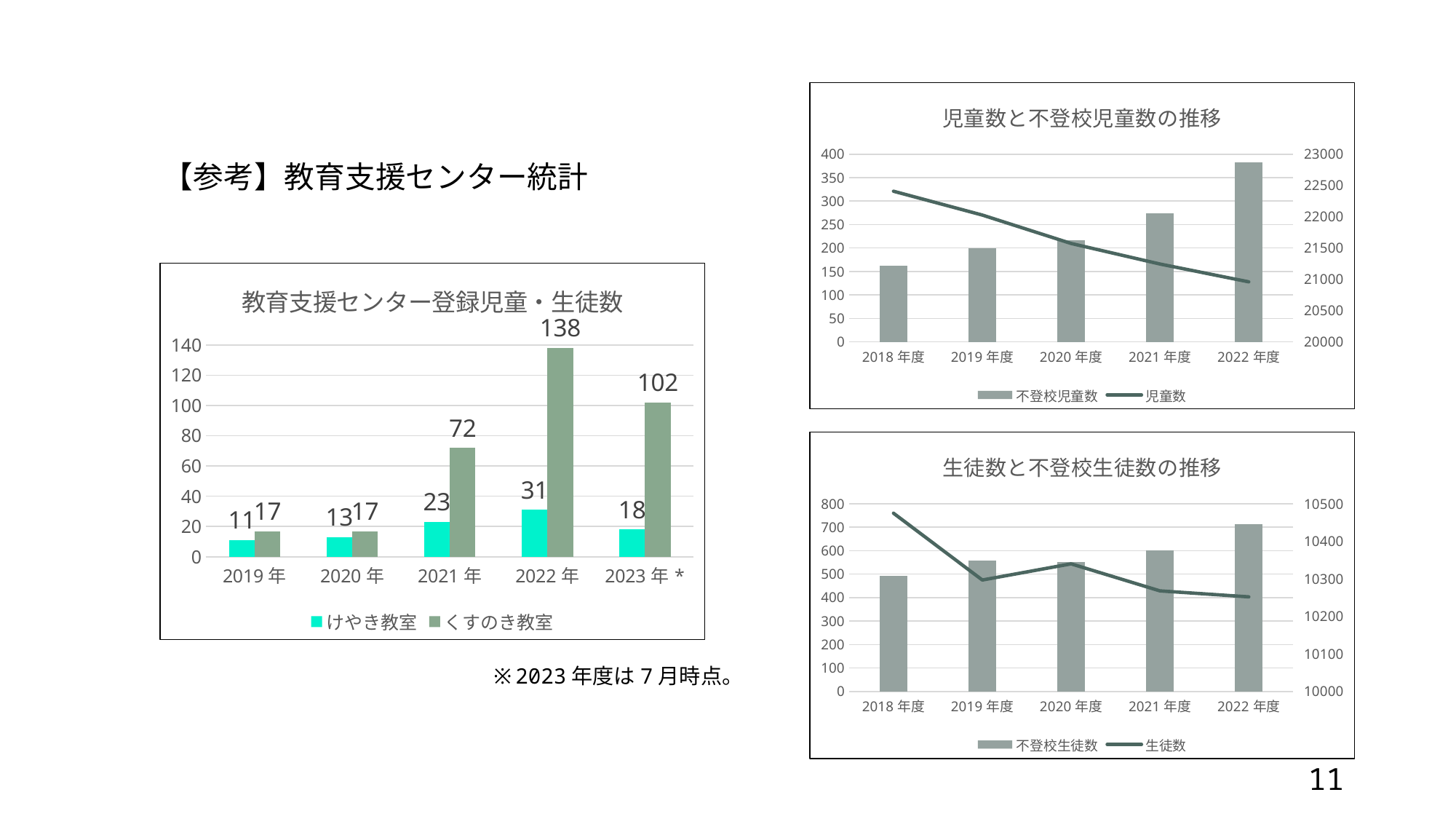
In the chart titled 生徒数と不登校生徒数の推移, which is larger, the 不登校生徒数 bar for 2021 年度 or for 2022 年度? 2022 年度 In the chart titled 教育支援センター登録児童・生徒数, what is the value for けやき教室 in 2021 年? 23 In the chart titled 教育支援センター登録児童・生徒数, how many series does the legend list? 2 In the chart titled 教育支援センター登録児童・生徒数, which year has the lowest value for けやき教室? 2019 年 In the chart titled 児童数と不登校児童数の推移, is the value of 不登校児童数 for 2022 年度 greater or less than 350? greater In the chart titled 教育支援センター登録児童・生徒数, what is the difference between くすのき教室 and けやき教室 in 2023 年*? 84 In the chart titled 教育支援センター登録児童・生徒数, how many years are shown on the x axis? 5 In the chart titled 児童数と不登校児童数の推移, which year has the highest 不登校児童数 bar? 2022 年度 In the chart titled 教育支援センター登録児童・生徒数, which year has the highest value for くすのき教室? 2022 年 In the chart titled 教育支援センター登録児童・生徒数, what is the value for くすのき教室 in 2022 年? 138 In the chart titled 児童数と不登校児童数の推移, does the 児童数 line rise or fall from 2018 年度 to 2022 年度? fall